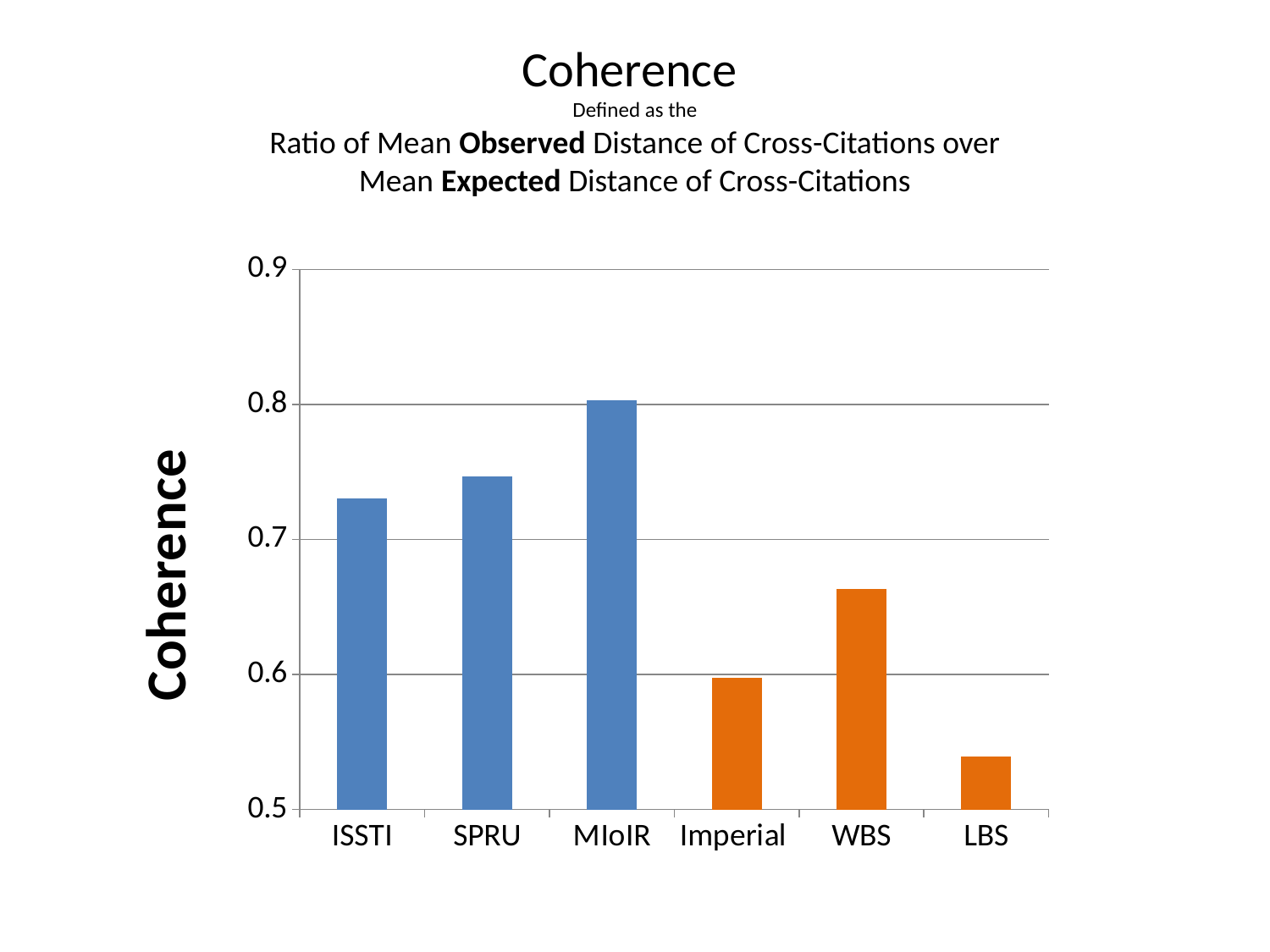
Which institution has the lowest coherence value? LBS What is the label on the vertical axis of the chart? Coherence Is the value for ISSTI greater or less than 0.7? greater Which has the larger coherence value, SPRU or LBS? SPRU Which institution has the highest coherence value? MIoIR How many institutions are shown on the x axis of the chart? 6 Is the value for Imperial greater or less than 0.7? less Is the value for SPRU greater or less than 0.7? greater Which has the larger coherence value, Imperial or WBS? WBS What kind of chart is shown on the slide? bar chart